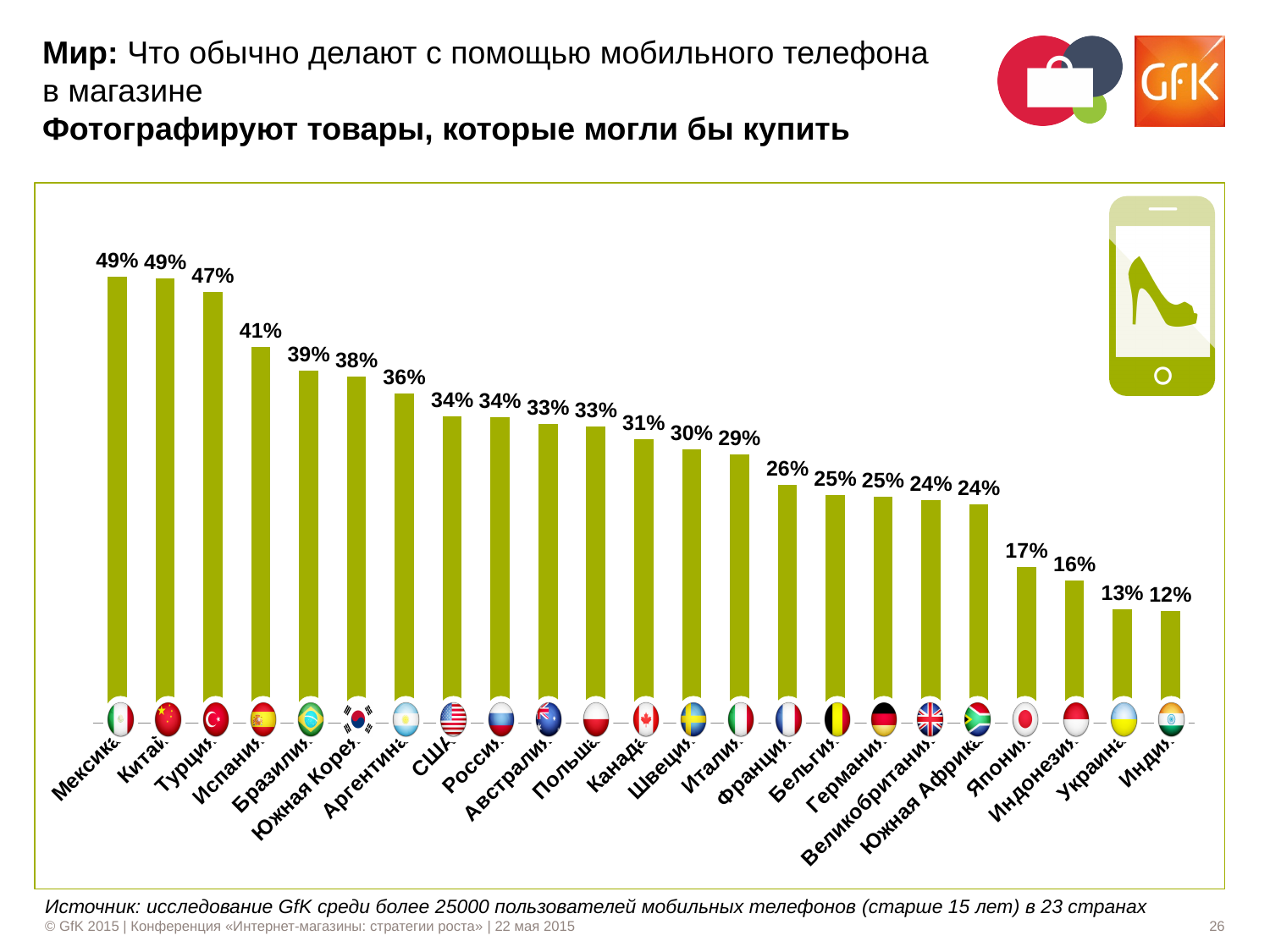
What is the value for Россия? 34% Which country has the lowest value in the chart? Индия Which has a larger value, Бразилия or Канада? Бразилия What is the value for Япония? 17% What is the bold subtitle of the chart on the slide? Фотографируют товары, которые могли бы купить Do the values rise or fall from left to right along the x axis? fall What is the value for Турция? 47% What is the value for Украина? 13% How many countries are shown in the chart? 23 What is the difference between the values for Мексика and Индия? 37% What type of chart is shown on the slide? bar chart What is the difference between the values for Испания and Германия? 16%